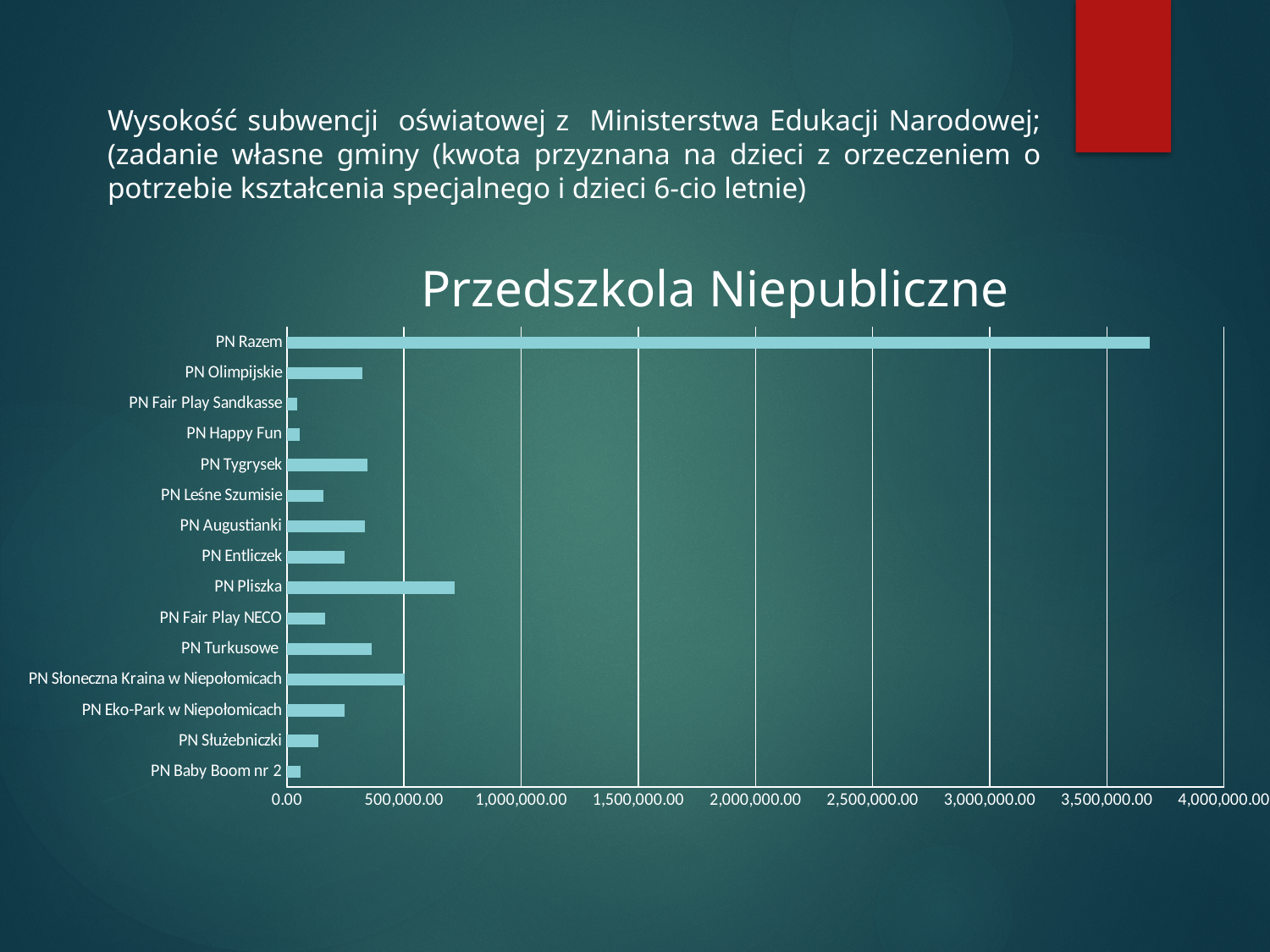
Is the value for PN Pliszka greater or less than 500,000.00? greater Which is larger, the value for PN Pliszka or the value for PN Turkusowe? PN Pliszka Is the value for PN Tygrysek greater or less than 1,000,000.00? less What is the title of the chart? Przedszkola Niepubliczne Is the value for PN Olimpijskie greater or less than 500,000.00? less How many categories are plotted on the chart? 15 Which is larger, the value for PN Olimpijskie or the value for PN Służebniczki? PN Olimpijskie What is the highest value shown on the horizontal axis? 4,000,000.00 What kind of chart is shown on the slide? bar chart Apart from PN Razem, which category has the longest bar? PN Pliszka Which category has the highest value? PN Razem